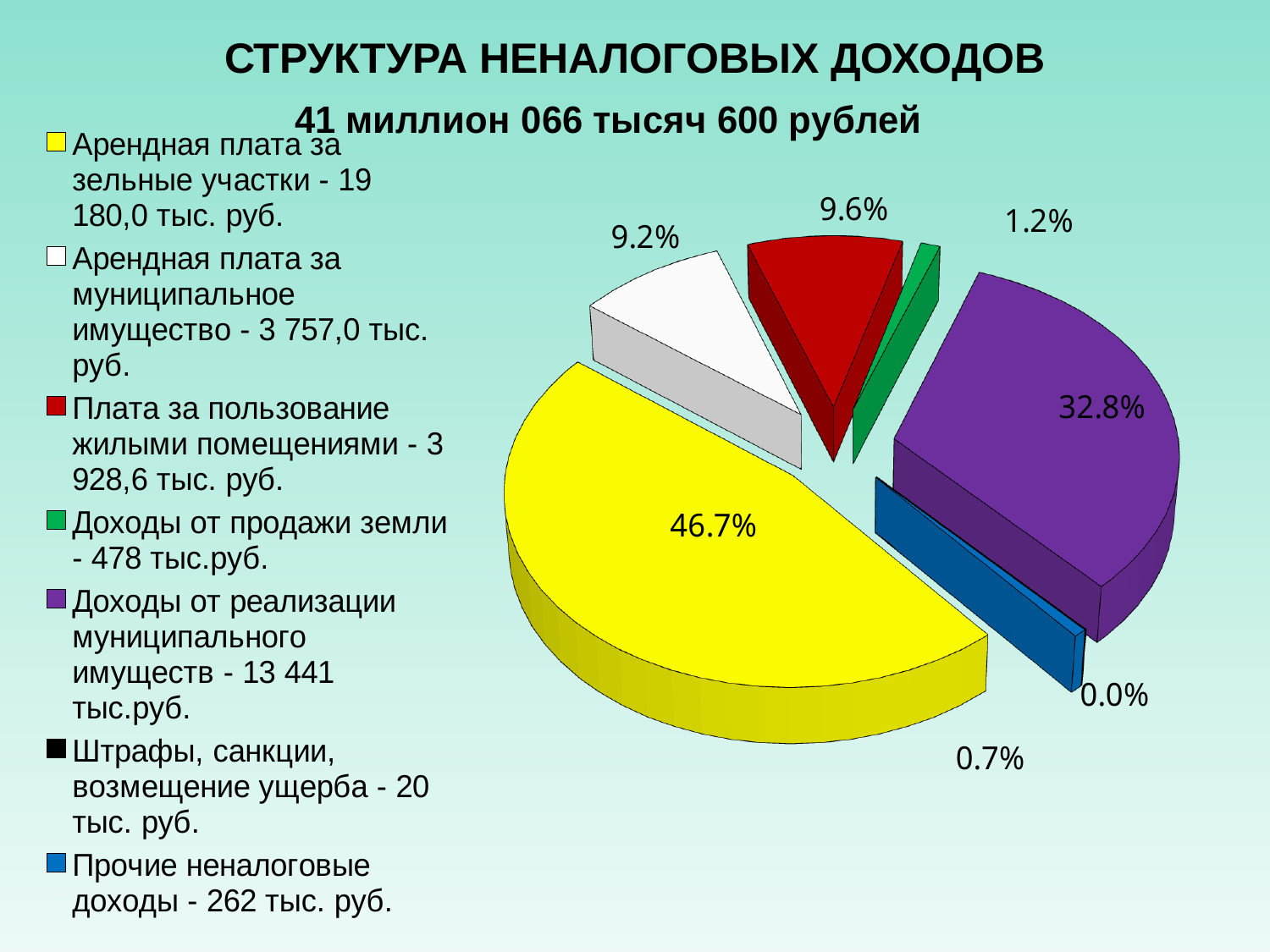
Which slice is larger: the red slice (Плата за пользование жилыми помещениями) or the white slice (Арендная плата за муниципальное имущество)? the red slice (Плата за пользование жилыми помещениями) What share of the pie does the yellow slice (Арендная плата за земельные участки) represent? 46.7% What share of the pie does the green slice (Доходы от продажи земли) represent? 1.2% What is the title of the chart on the slide? 41 миллион 066 тысяч 600 рублей Which category has the largest share of the pie? Арендная плата за зельные участки What kind of chart is shown on the slide? pie chart According to the legend, what is the amount for Доходы от продажи земли? 478 тыс.руб. What is the difference in percentage points between the yellow slice (46.7%) and the purple slice (32.8%)? 13.9 What share of the pie does the red slice (Плата за пользование жилыми помещениями) represent? 9.6% How many categories does the legend list? 7